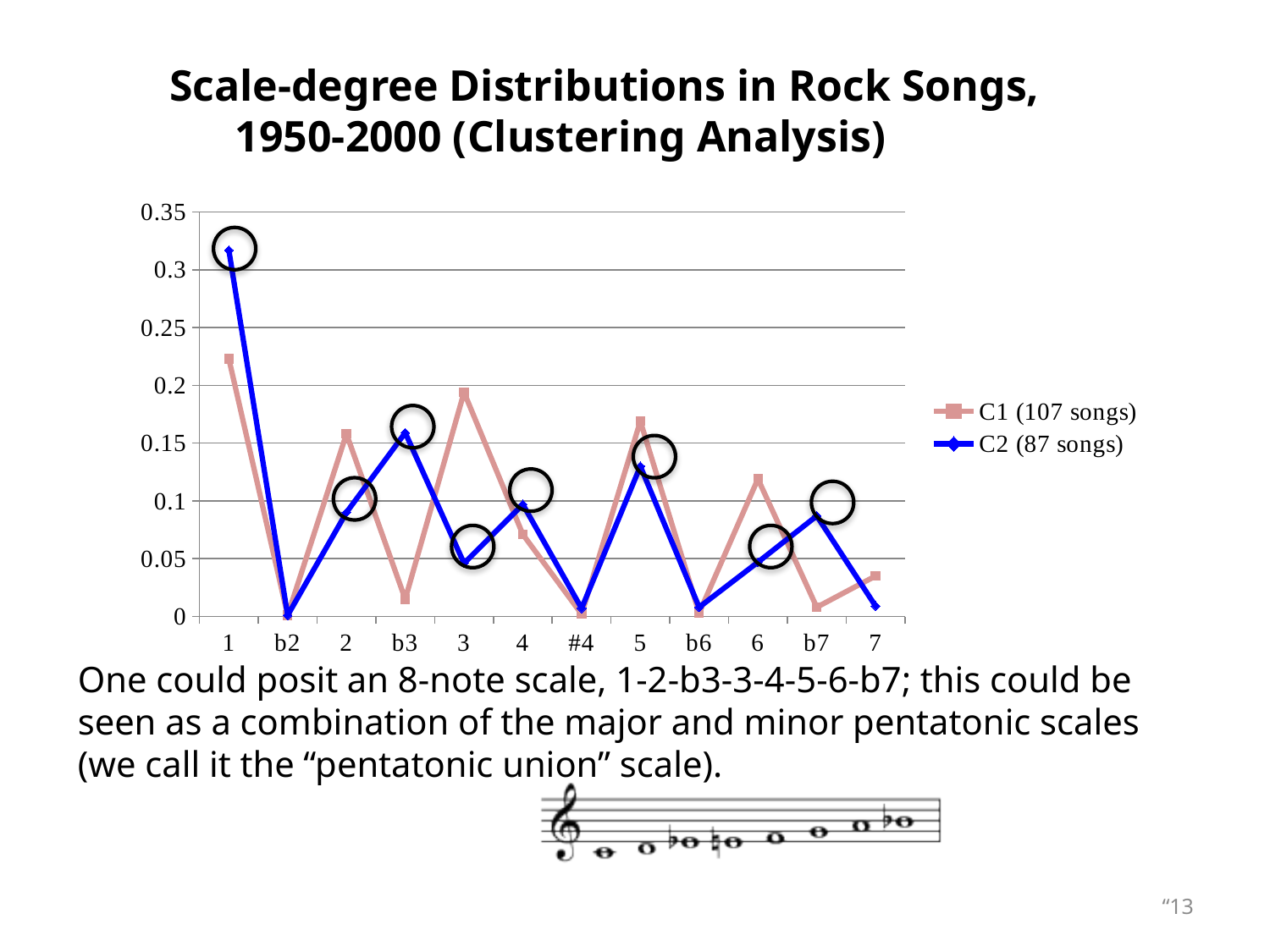
What kind of chart is shown on the slide? line chart Which scale degree has the highest value for the C1 (107 songs) series? 1 Is the value for C1 (107 songs) at scale degree 1 greater or less than 0.2? greater At scale degree b3, which series has the larger value, C1 (107 songs) or C2 (87 songs)? C2 (87 songs) At scale degree 3, which series has the larger value, C1 (107 songs) or C2 (87 songs)? C1 (107 songs) How many series does the legend list? 2 Is the value for C2 (87 songs) at scale degree 6 greater or less than 0.1? less Is the value for C1 (107 songs) at scale degree 6 greater or less than 0.1? greater Which scale degree has the highest value for the C2 (87 songs) series? 1 How many scale-degree categories are shown on the x axis? 12 What colour is the line for the C2 (87 songs) series? blue